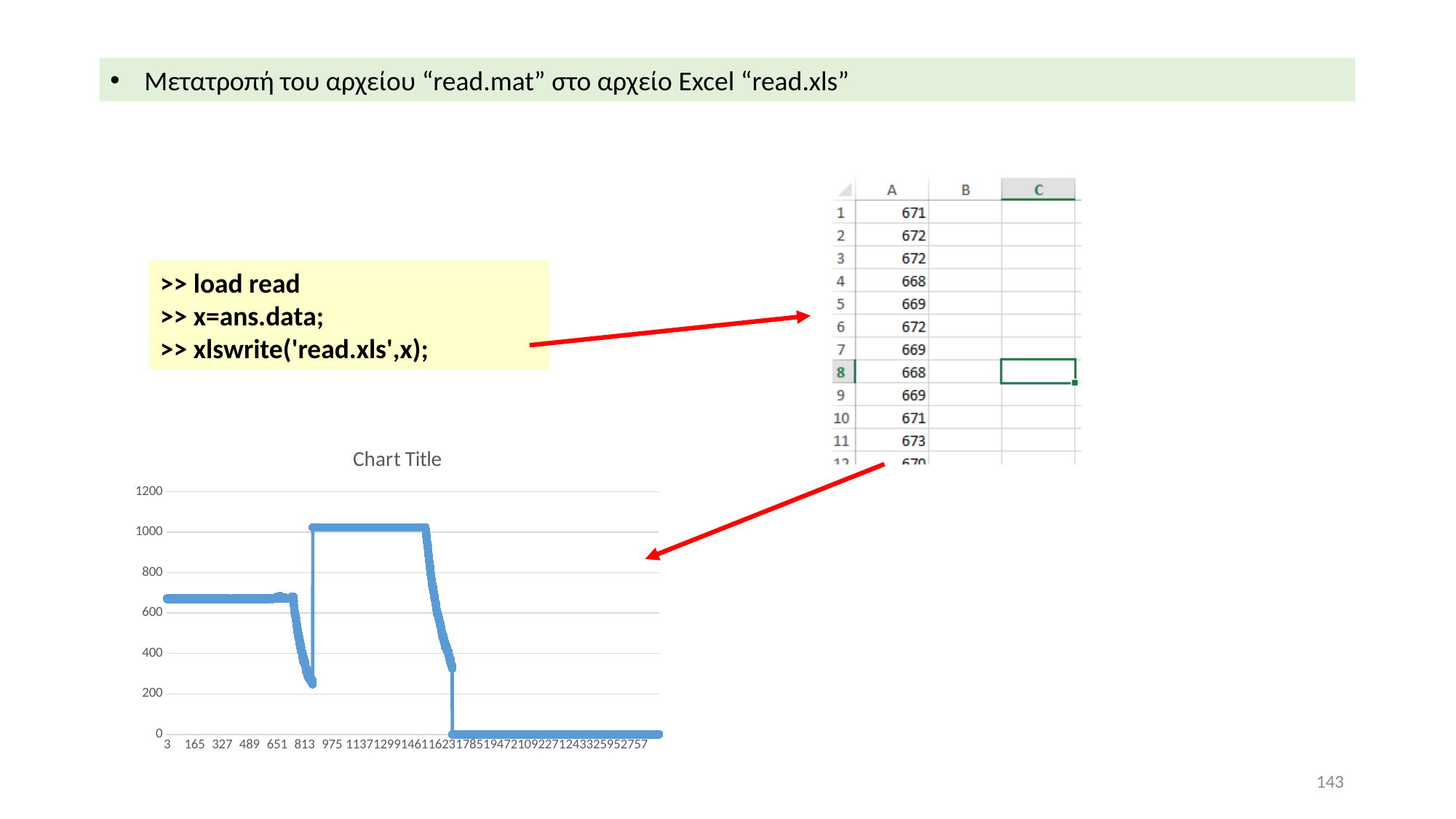
Is the value at the last x-axis label (2757) greater or less than 200? less Comparing the start of the x axis to the end, do the plotted values rise or fall overall? fall What kind of chart is shown on the slide? line chart How many tick labels are shown on the x axis? 18 Is the value at the first x-axis label (3) greater or less than 600? greater What is the highest tick value shown on the y axis? 1200 How many data series are plotted in the chart? 1 Is the value at x-axis label 975 greater or less than 800? greater What is the title of the chart? Chart Title Is the value at x-axis label 1137 larger or smaller than the value at x-axis label 2271? larger